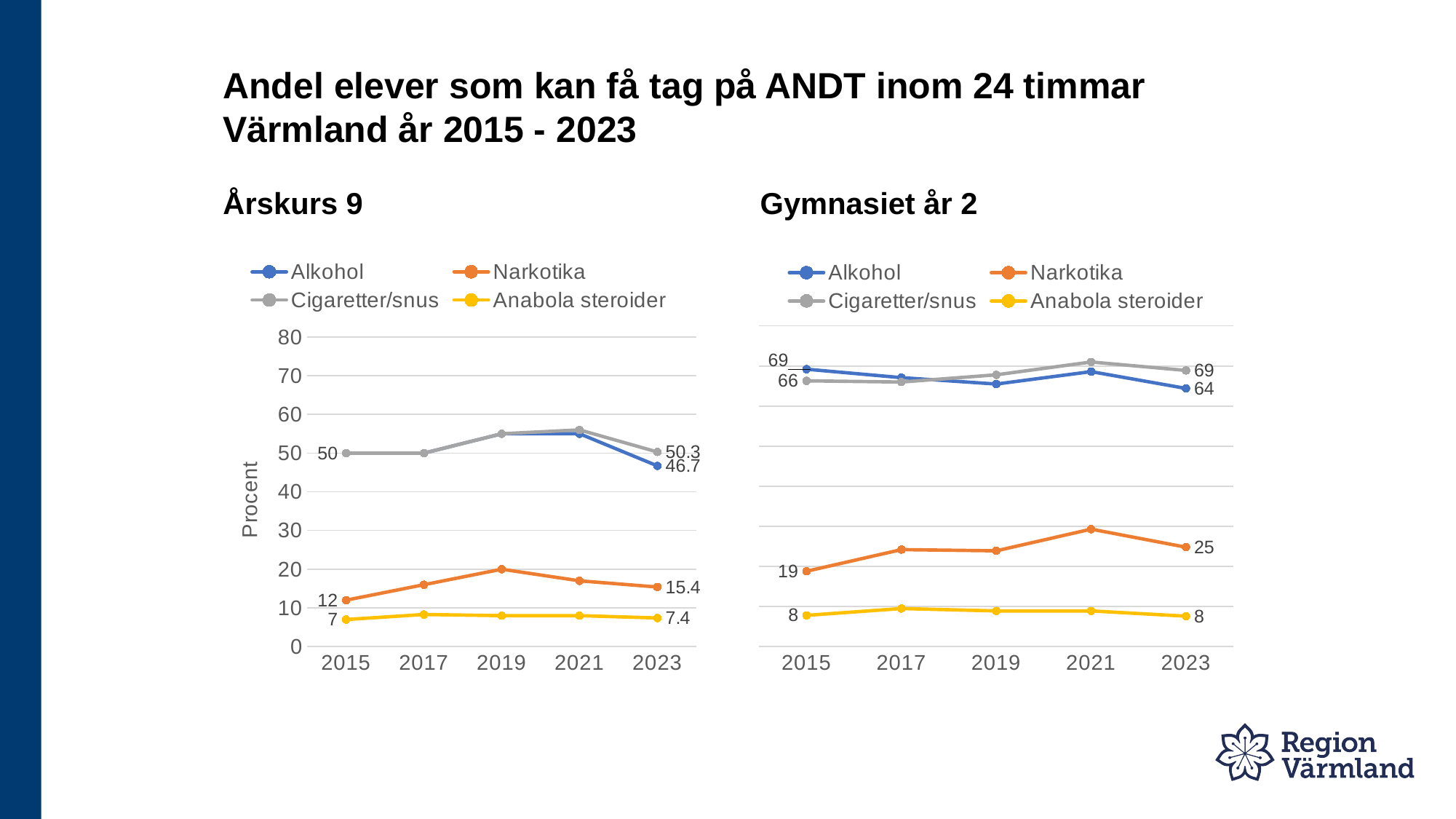
In the Gymnasiet år 2 chart, which series has the highest value in 2023? Cigaretter/snus In the Gymnasiet år 2 chart, what is the value for Narkotika in 2023? 25 How many series does the legend of the Gymnasiet år 2 chart list? 4 In the Årskurs 9 chart, is the value for Narkotika in 2019 greater or less than 30? less In the Årskurs 9 chart, what is the value for Narkotika in 2023? 15.4 In the Årskurs 9 chart, what is the value for Alkohol in 2023? 46.7 In the Årskurs 9 chart, what is the value for Anabola steroider in 2015? 7 In the Årskurs 9 chart, which series has the lowest value in 2023? Anabola steroider How many years are shown on the x axis of the Årskurs 9 chart? 5 In the Gymnasiet år 2 chart, what is the difference between the Narkotika values in 2023 and 2015? 6 In the Gymnasiet år 2 chart, what is the value for Alkohol in 2015? 69 What type of chart is the Årskurs 9 chart? line chart